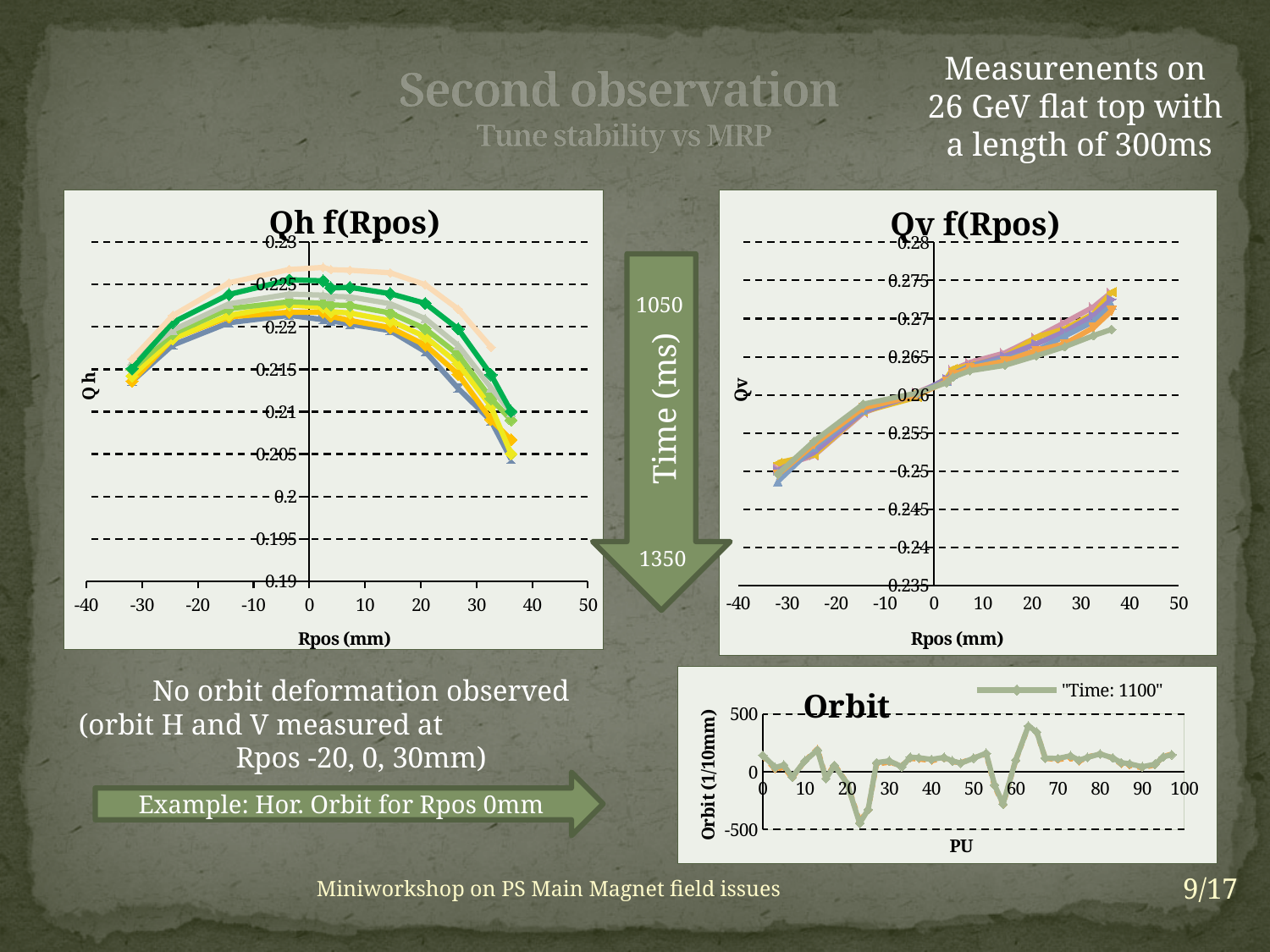
In the "Orbit" chart, what is the label of the y axis? Orbit (1/10mm) In the "Qh f(Rpos)" chart, do the Qh values rise or fall as Rpos increases from 10 to 35 mm? fall In the "Orbit" chart, is the lowest orbit value (near PU 23) greater or less than -250? less What kind of chart is the "Qh f(Rpos)" chart? line chart In the "Qh f(Rpos)" chart, are the Qh values at Rpos 0 mm greater or less than 0.215? greater How many series does the legend of the "Orbit" chart list? 1 How many charts are shown on the slide? 3 In the "Qv f(Rpos)" chart, are the Qv values at Rpos -30 mm greater or less than 0.26? less In the "Qh f(Rpos)" chart, what is the label of the x axis? Rpos (mm) In the "Qv f(Rpos)" chart, do the Qv values rise or fall as Rpos increases from -30 to 35 mm? rise What kind of chart is the "Orbit" chart? line chart